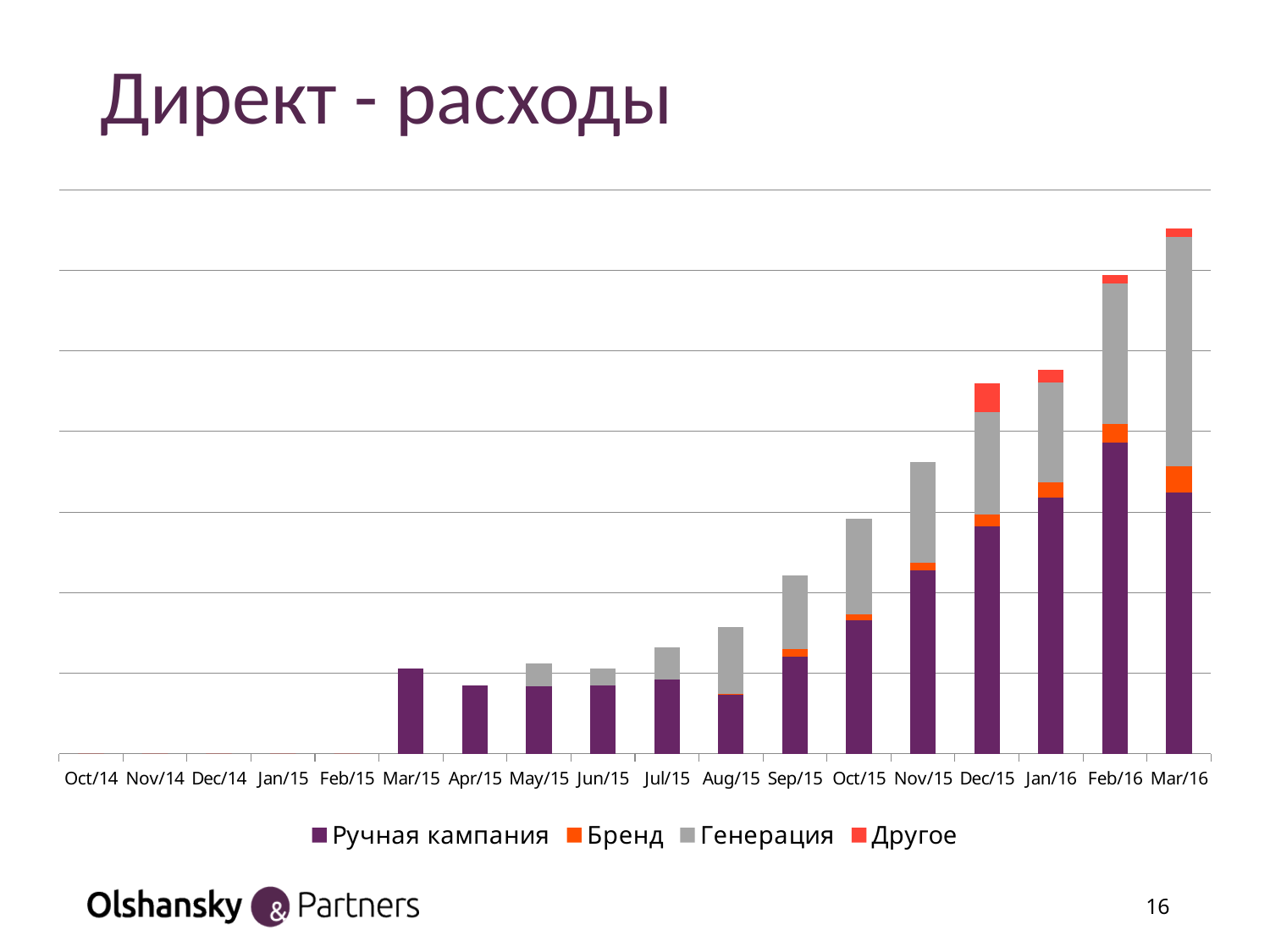
Which month has the largest Другое segment? Dec/15 Which is the first month with a visible bar? Mar/15 Which month has the tallest stacked bar? Mar/16 What is the title of the chart on the slide? Директ - расходы How many series does the legend list? 4 How many months are shown along the x axis? 18 What kind of chart is shown on the slide? Stacked bar chart Which series are listed in the legend? Ручная кампания, Бренд, Генерация, Другое Do the total bar heights generally rise or fall from Mar/15 to Mar/16? Rise Which is larger, the Ручная кампания segment in Feb/16 or in Mar/16? Feb/16 Which is larger, the Генерация segment in Feb/16 or in Mar/16? Mar/16 Which is larger, the total bar for Feb/16 or for Mar/16? Mar/16